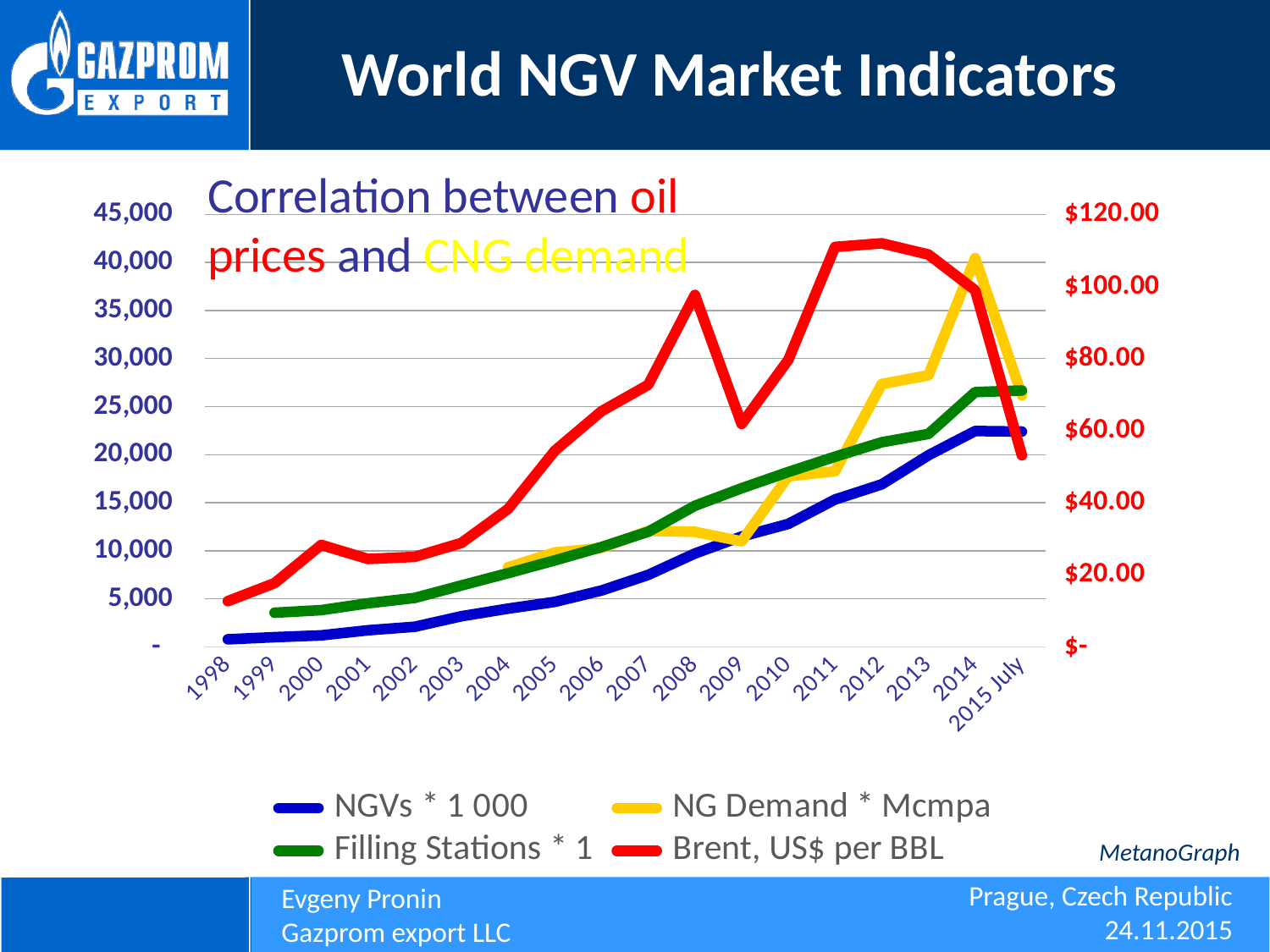
Is the value for NGVs * 1 000 in 2014 greater or less than 20,000? greater How many series does the chart legend list? 4 Does the NGVs * 1 000 series rise or fall from 1998 to 2014? rise Is the value for Brent, US$ per BBL in 2008 greater or less than $80.00? greater In 2010, which is larger: NGVs * 1 000 or Filling Stations * 1? Filling Stations * 1 In which year does the NG Demand * Mcmpa series reach its highest value? 2014 How many years (categories) are shown along the x axis? 18 Which colour is used for the Brent, US$ per BBL series? red Is the value for Brent, US$ per BBL in 2009 greater or less than $80.00? less What is the title shown on the chart? Correlation between oil prices and CNG demand What kind of chart is shown on the slide? line chart